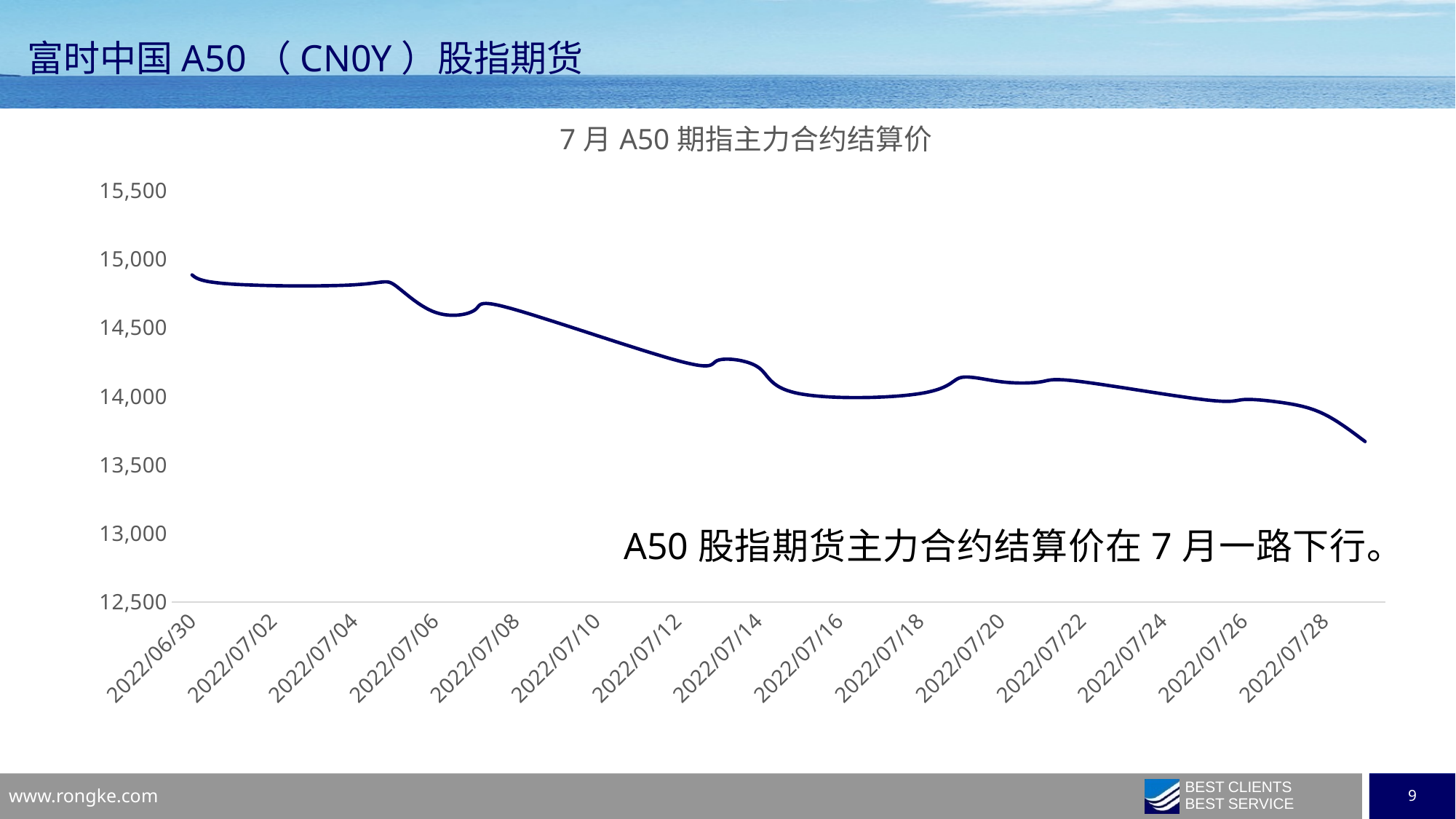
Is the lowest value of the series at the start or at the end of the period? end How many date labels are shown on the x axis? 15 Is the value at the final point of the line greater or less than 14,000? less Is the value for 2022/07/10 greater or less than 14,000? greater What is the highest tick value shown on the y axis? 15,500 Do the values generally rise or fall from 2022/06/30 to the end of July? fall Is the value for 2022/06/30 greater or less than 15,000? less What is the title of the chart? 7月A50期指主力合约结算价 What kind of chart is shown on the slide? line chart Which date has the larger value, 2022/07/04 or 2022/07/20? 2022/07/04